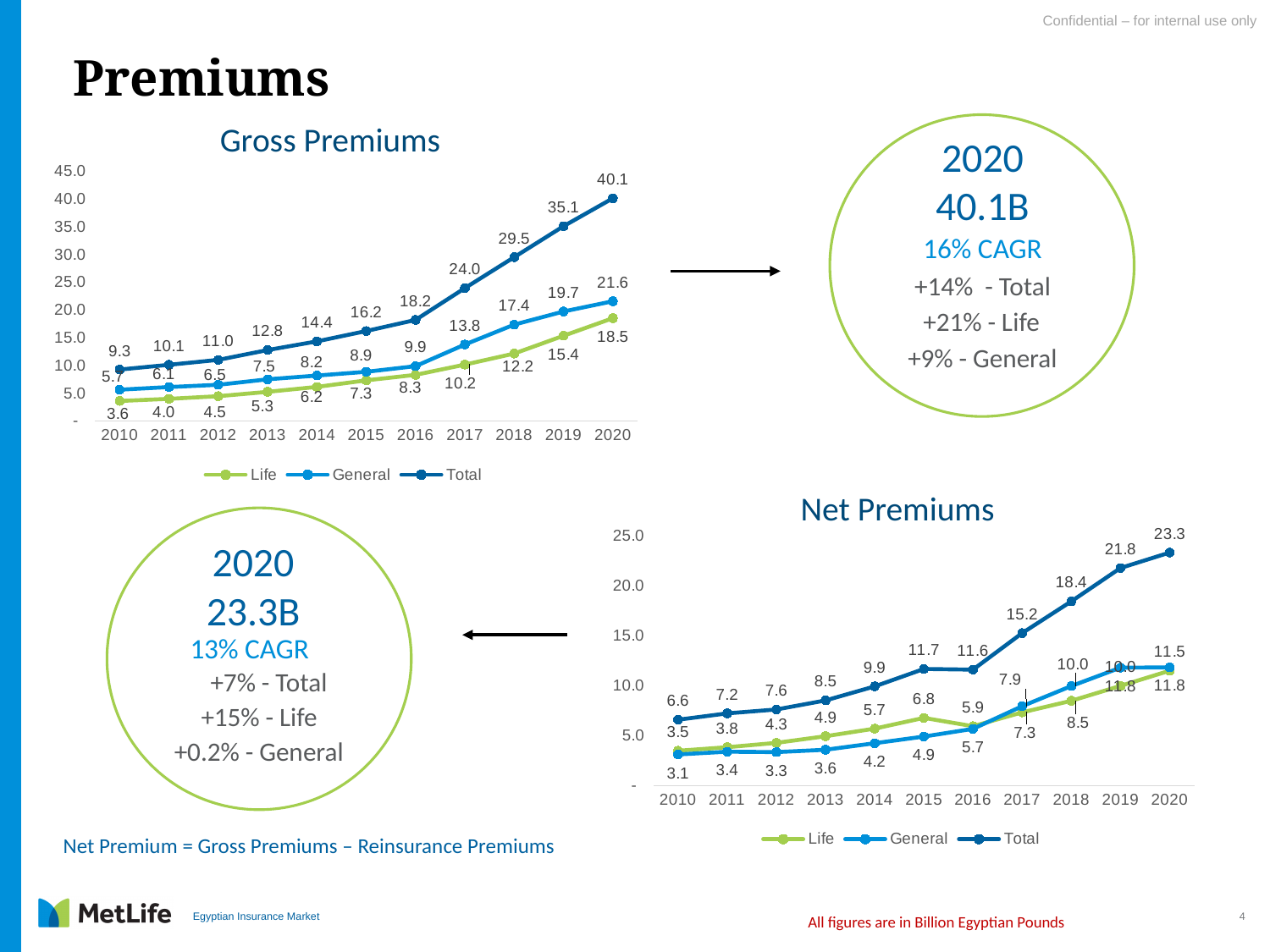
In the Gross Premiums chart, what is the difference between the Total values for 2020 and 2019? 5.0 How many series does the legend of the Net Premiums chart list? 3 In the Net Premiums chart, what is the difference between the Total values for 2020 and 2019? 1.5 In the Gross Premiums chart, what is the General value for 2017? 13.8 How many years are shown on the x axis of the Gross Premiums chart? 11 In the Net Premiums chart, what is the Total value for 2015? 11.7 In the Gross Premiums chart, what is the Total value for 2020? 40.1 What kind of chart is the Gross Premiums chart? Line chart In the Gross Premiums chart, which is larger in 2018: General or Life? General In the Gross Premiums chart, is the Total value for 2017 greater or less than 20.0? greater In the Net Premiums chart, which year has the highest Total value? 2020 In the Gross Premiums chart, what is the Life value for 2010? 3.6